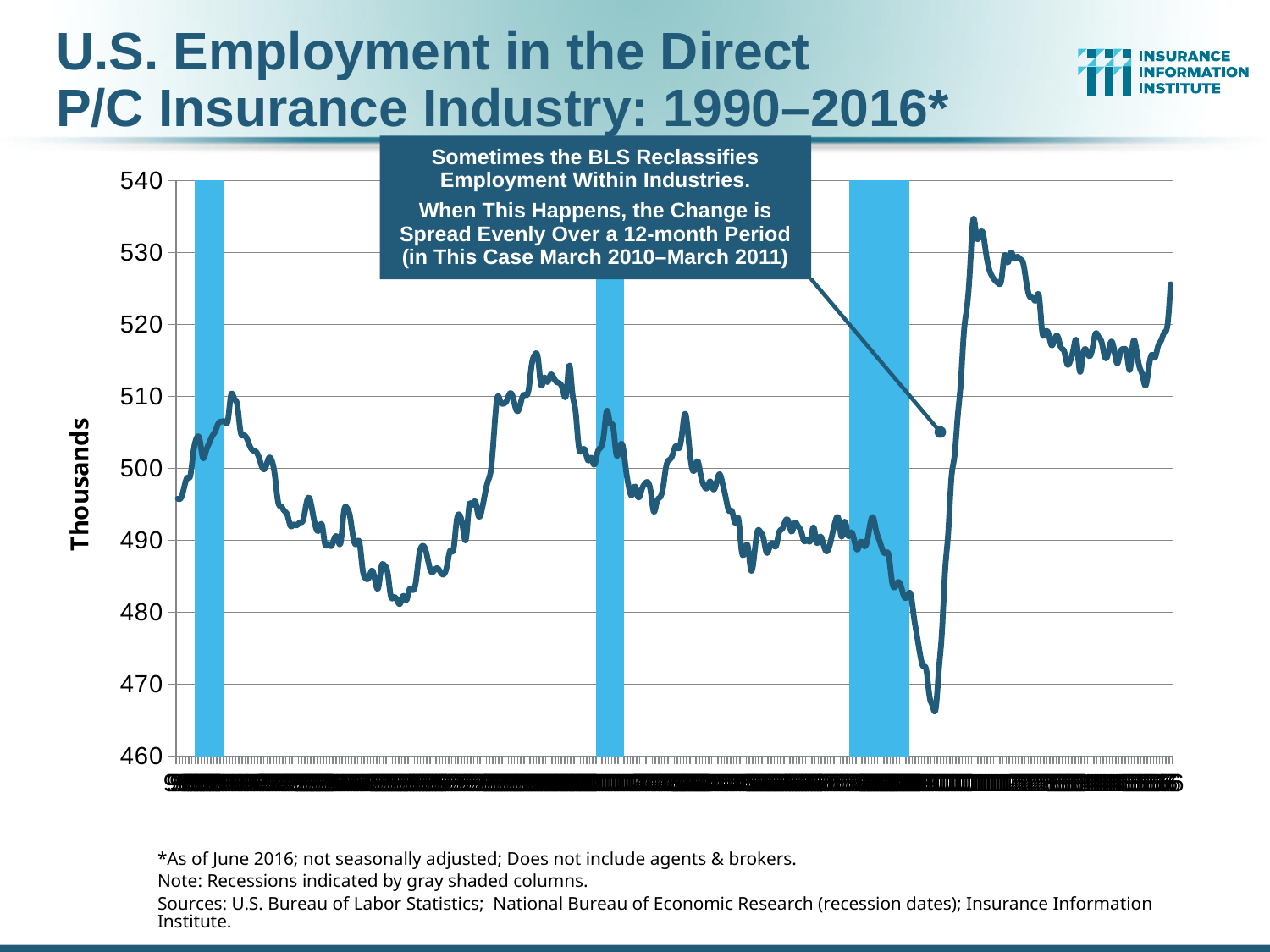
Is the highest point on the line greater or less than 530? greater Is the first value at the left end of the line greater or less than 500? less What kind of chart is shown on the slide? line chart What is the title of the vertical axis? Thousands Immediately after the third (rightmost) shaded column, does the line rise or fall? fall Does the line end higher or lower at the right end than it starts at the left end? higher What is the highest value labelled on the vertical axis? 540 How many shaded recession columns are drawn on the chart? 3 Is the lowest point on the line greater or less than 470? less How many data series are plotted on the chart? 1